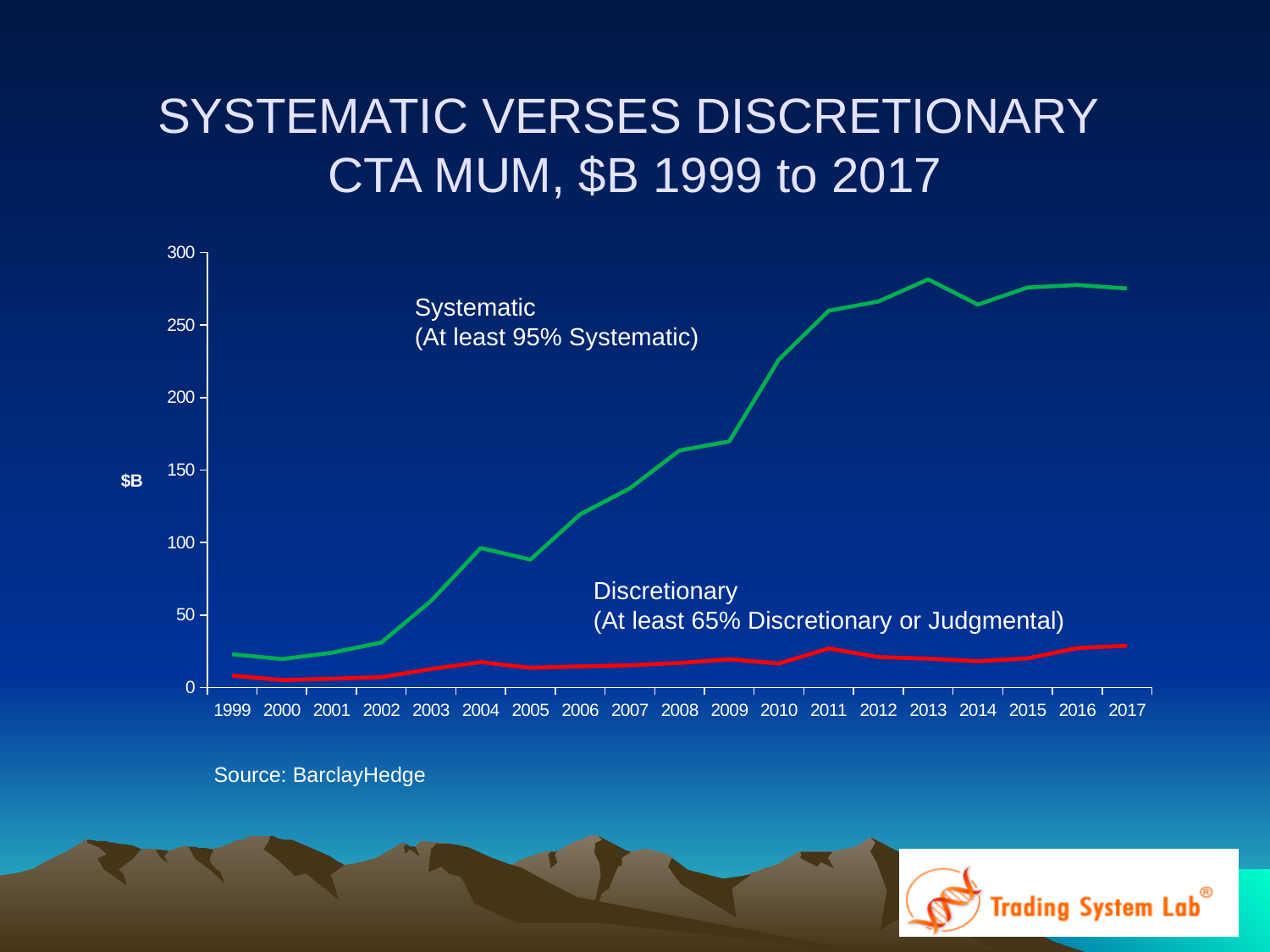
Is the Systematic value for 2005 greater or less than 100? less Is the Discretionary value for 2017 greater or less than 50? less What kind of chart is shown on the slide? line chart What colour is the Systematic line? green Is the Systematic value for 2002 greater or less than 50? less How many years are shown along the x axis? 19 How many series are plotted on the chart? 2 What is the label on the y axis? $B Which series has the larger value in 2017, Systematic or Discretionary? Systematic Does the Systematic series generally rise or fall from 1999 to 2017? rise